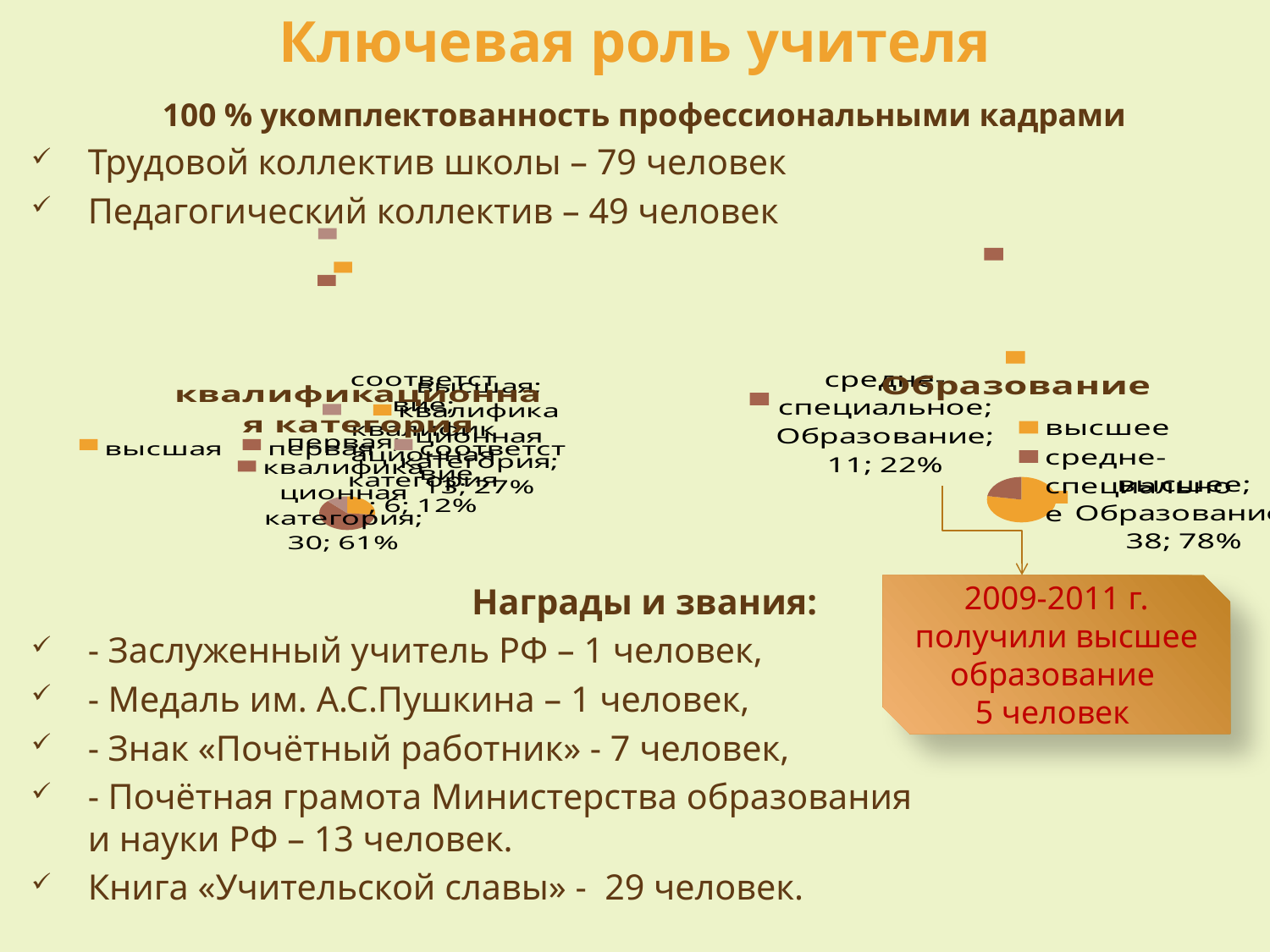
In the "Образование" chart, how many teachers have secondary specialised education (средне-специальное)? 11 In the "Образование" chart, which category is the largest? высшее How many entries does the legend of the "Образование" chart list? 2 In the "Образование" chart, how many teachers have higher education (высшее)? 38 In the "квалификационная категория" chart, what percentage share does the highest category (высшая) have? 27% What type of chart is the "квалификационная категория" chart on the left of the slide? pie chart In the "Образование" chart, what percentage share does secondary specialised education (средне-специальное) have? 22% What type of chart is the "Образование" chart on the right of the slide? pie chart In the "квалификационная категория" chart, which category is the largest? первая In the "квалификационная категория" chart, how many teachers have the highest qualification category (высшая)? 13 In the "Образование" chart, what percentage share does higher education (высшее) have? 78% In the "Образование" chart, what is the difference between the number of teachers with higher education and those with secondary specialised education? 27